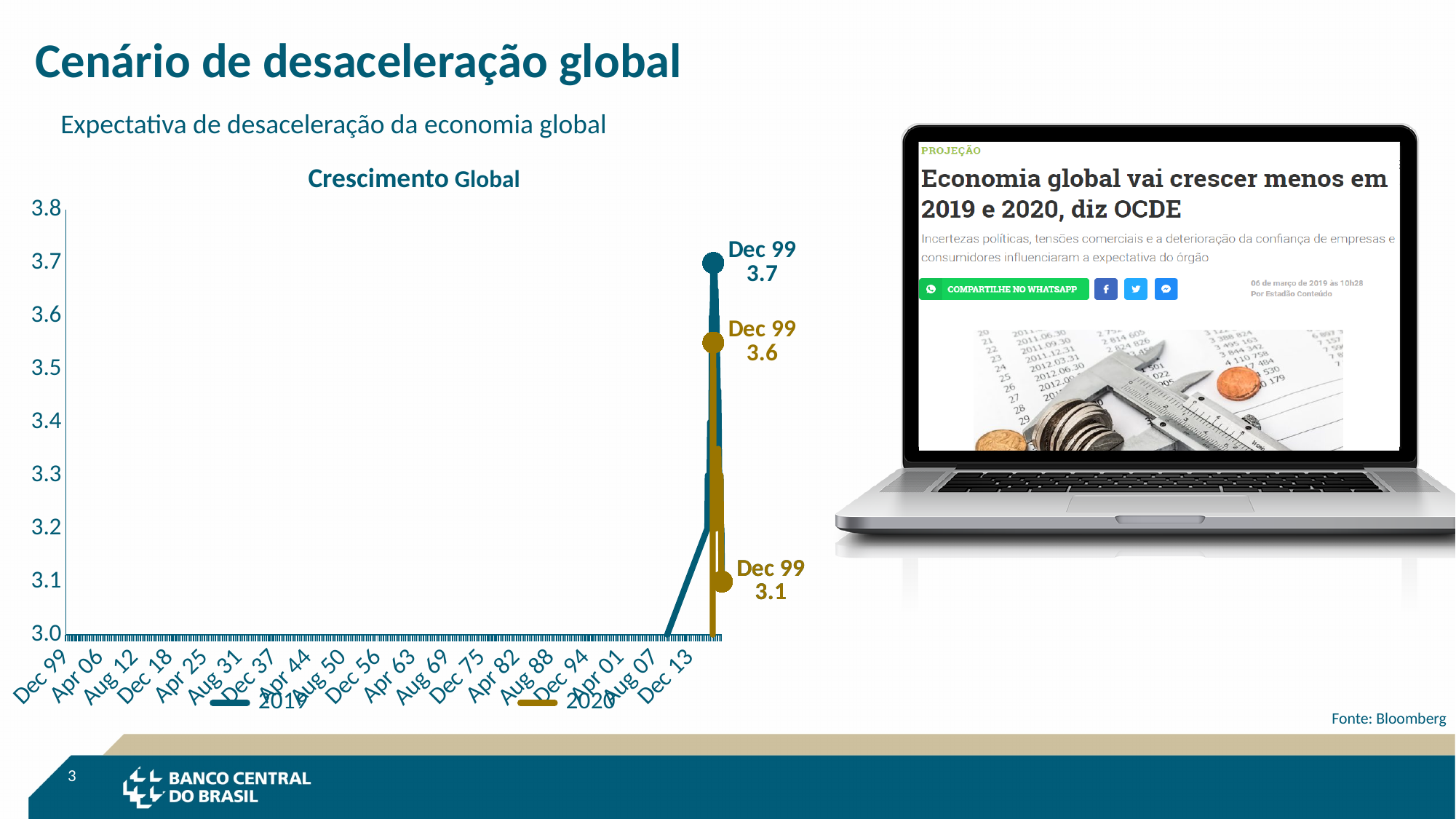
What are the two series named in the chart's legend? 2019 and 2020 How many series does the chart's legend list? 2 What is the highest value printed as a data label on the chart? 3.7 What is the lowest value printed as a data label on the chart? 3.1 What is the maximum value shown on the chart's vertical axis? 3.8 Which is larger, the labelled value of the 2019 series (3.7) or the upper labelled value of the 2020 series (3.6)? 3.7 (2019) What is the minimum value shown on the chart's vertical axis? 3.0 What kind of chart is shown on the slide? line chart Is the labelled value 3.1 on the chart greater or less than 3.5? less What is the difference between the two labelled values of the 2020 series, 3.6 and 3.1? 0.5 What is the title of the chart on the slide? Crescimento Global What is the difference between the highest labelled value (3.7) and the lowest labelled value (3.1) on the chart? 0.6